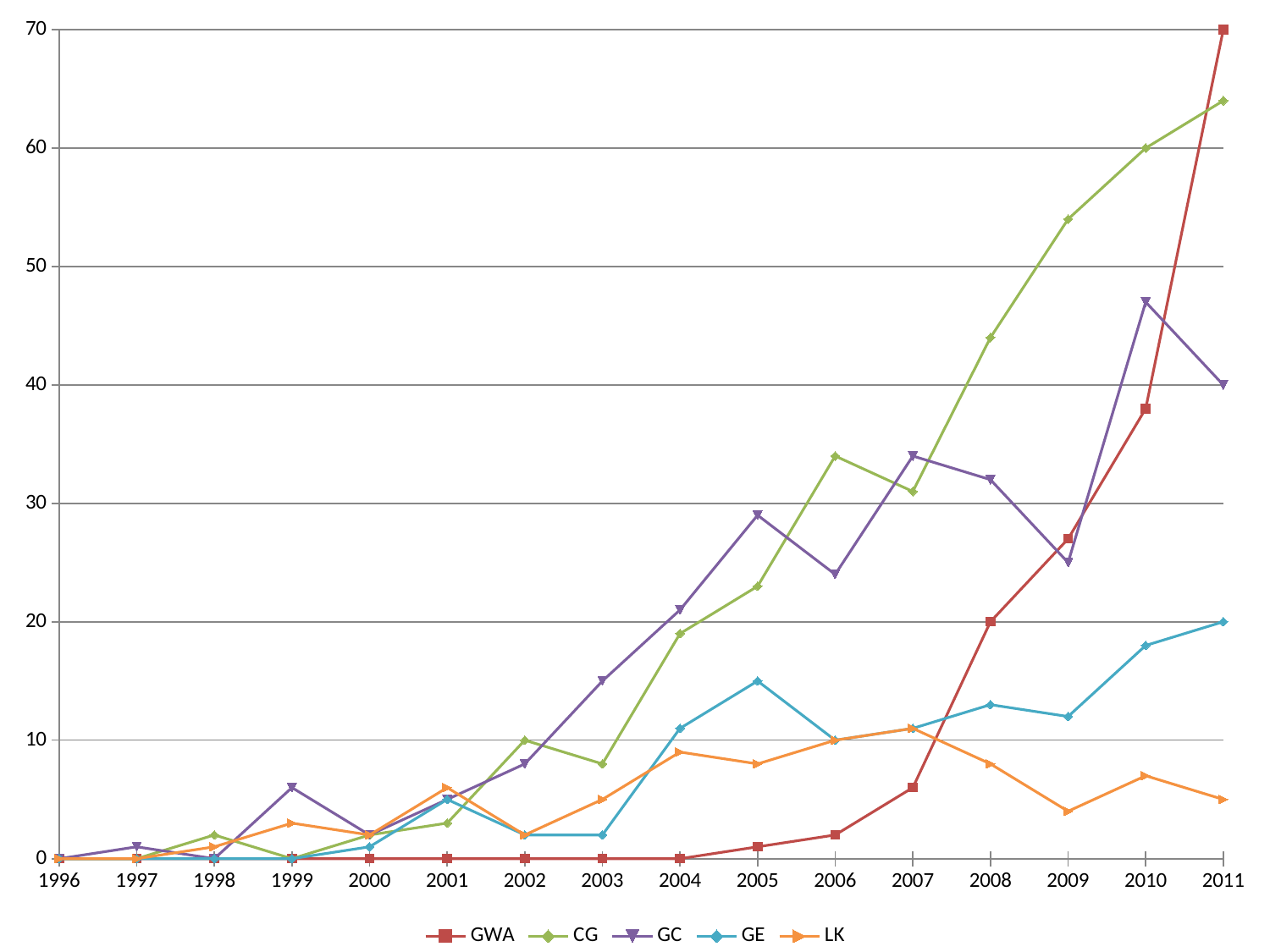
Which series has the lowest value in 2011? LK Which series has the highest value in 2011? GWA What is the value for GWA in 2003? 0 What is the value for CG in 2010? 60 How many years are shown along the x axis? 16 What is the value for GC in 2011? 40 Is the value for CG in 2008 greater or less than 40? greater Which is larger in 2009, CG or GC? CG What kind of chart is shown on the slide? line chart Does the CG series generally rise or fall from 2004 to 2011? rise What is the value for GWA in 2011? 70 How many series does the legend list? 5